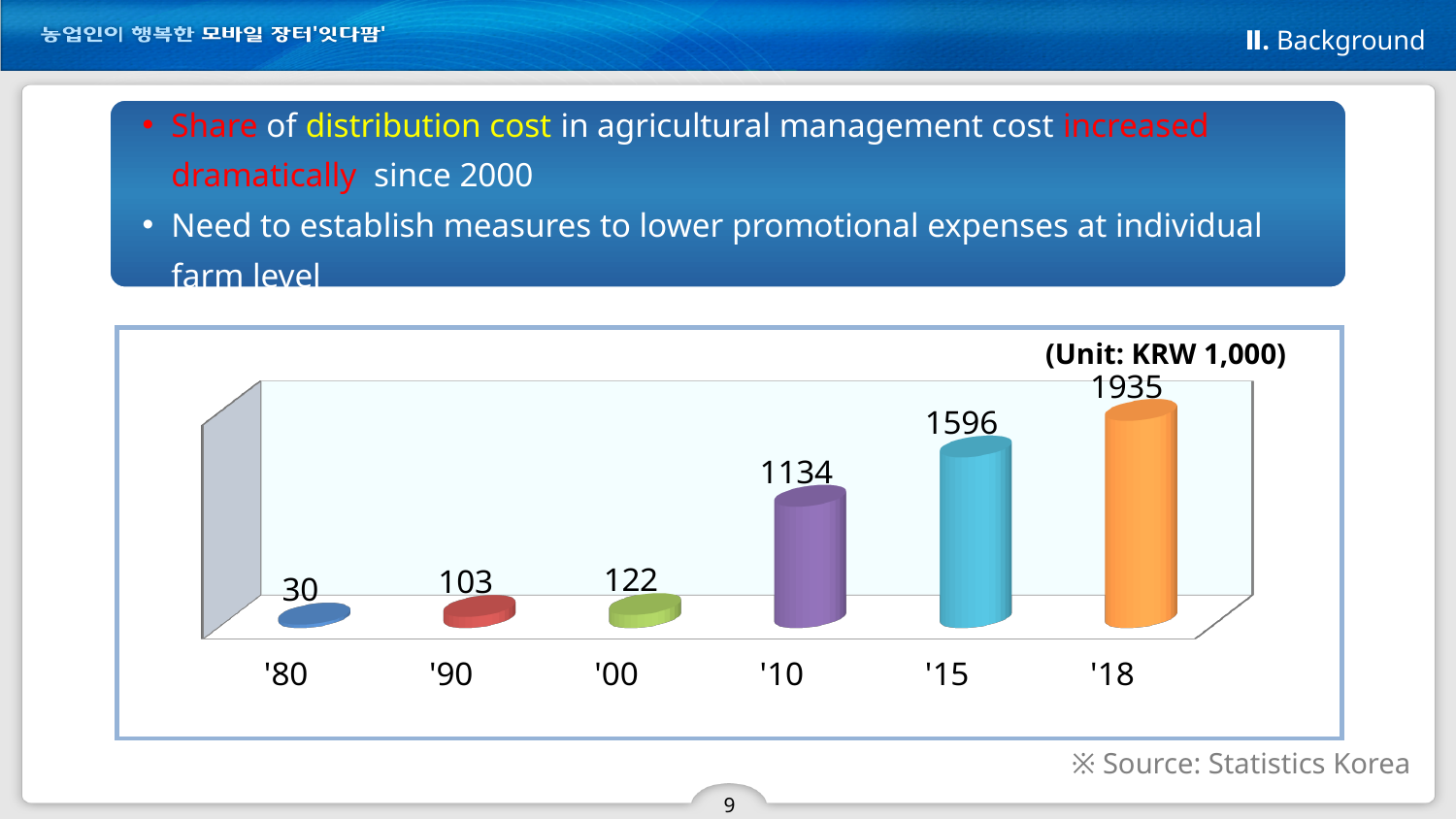
How many years are shown on the x axis? 6 What kind of chart is shown? bar chart What is the value for '80? 30 What is the value for '10? 1134 Which year has the lowest value? '80 Which is larger, the value for '10 or the value for '15? '15 What is the difference between the values for '00 and '90? 19 What is the value for '18? 1935 Which year has the highest value? '18 What unit is stated for the chart values? KRW 1,000 Do the values rise or fall from '80 to '18? rise What is the difference between the values for '18 and '15? 339